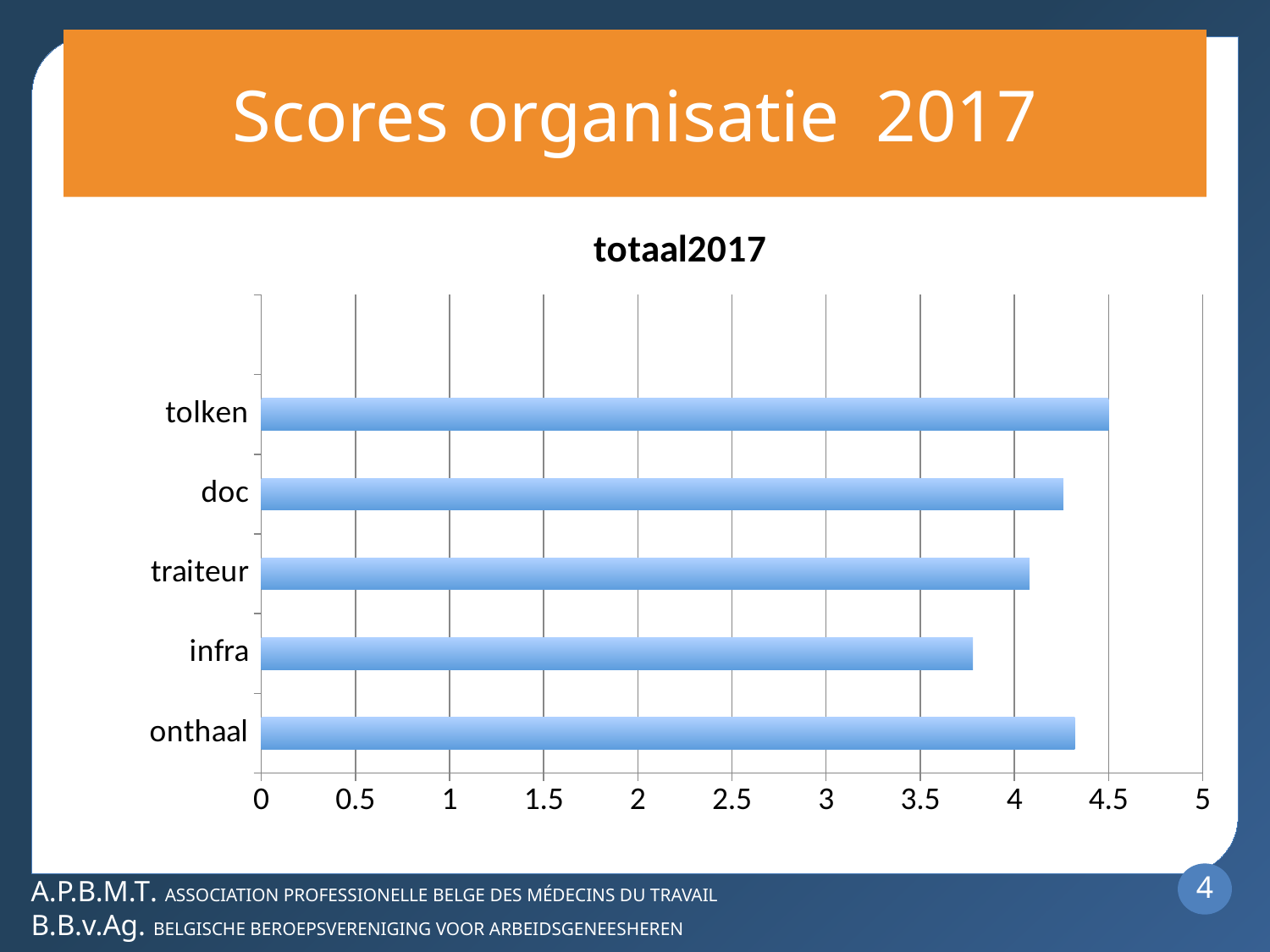
Which is larger, the value for traiteur or the value for infra? traiteur What is the title of the chart? totaal2017 Is the value for infra greater or less than 3.5? greater Which is larger, the value for tolken or the value for doc? tolken Which category has the highest value? tolken Which category has the lowest value? infra Is the value for infra greater or less than 4? less What is the maximum value shown on the horizontal axis? 5 Is the value for traiteur greater or less than 4? greater How many categories are plotted in the chart? 5 What kind of chart is shown on the slide? bar chart